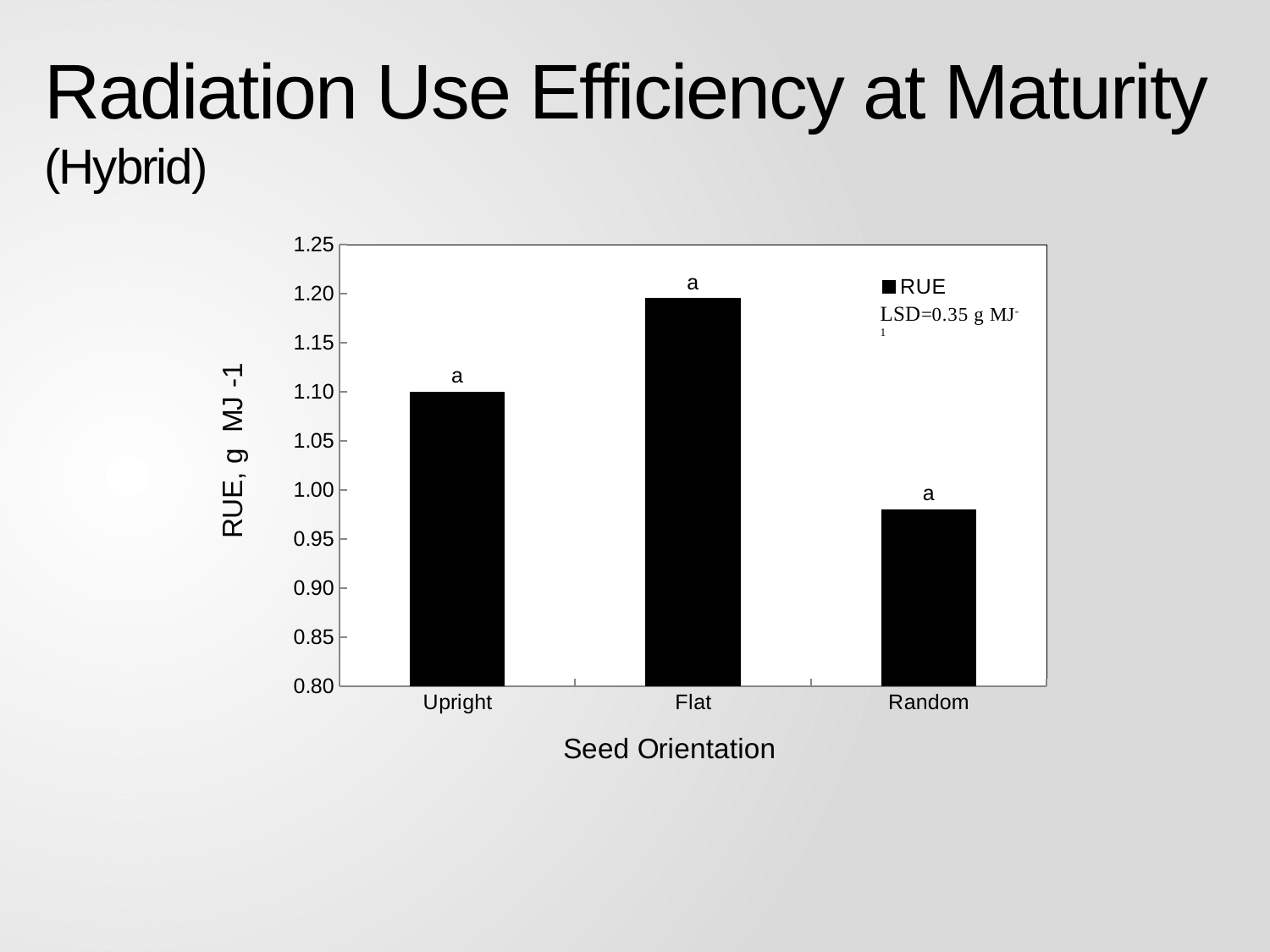
Which has a larger RUE value, Flat or Upright? Flat Which seed orientation has the lowest RUE value? Random Is the RUE value for Upright greater or less than 1.05? greater Is the RUE value for Random greater or less than 1.00? less How many series does the chart legend list? 1 Is the RUE value for Flat greater or less than 1.15? greater Which seed orientation has the highest RUE value? Flat What is the label of the x axis of the chart? Seed Orientation What kind of chart is shown on the slide? bar chart How many seed orientation categories are plotted on the chart? 3 What series name is shown in the chart legend? RUE Which has a larger RUE value, Upright or Random? Upright